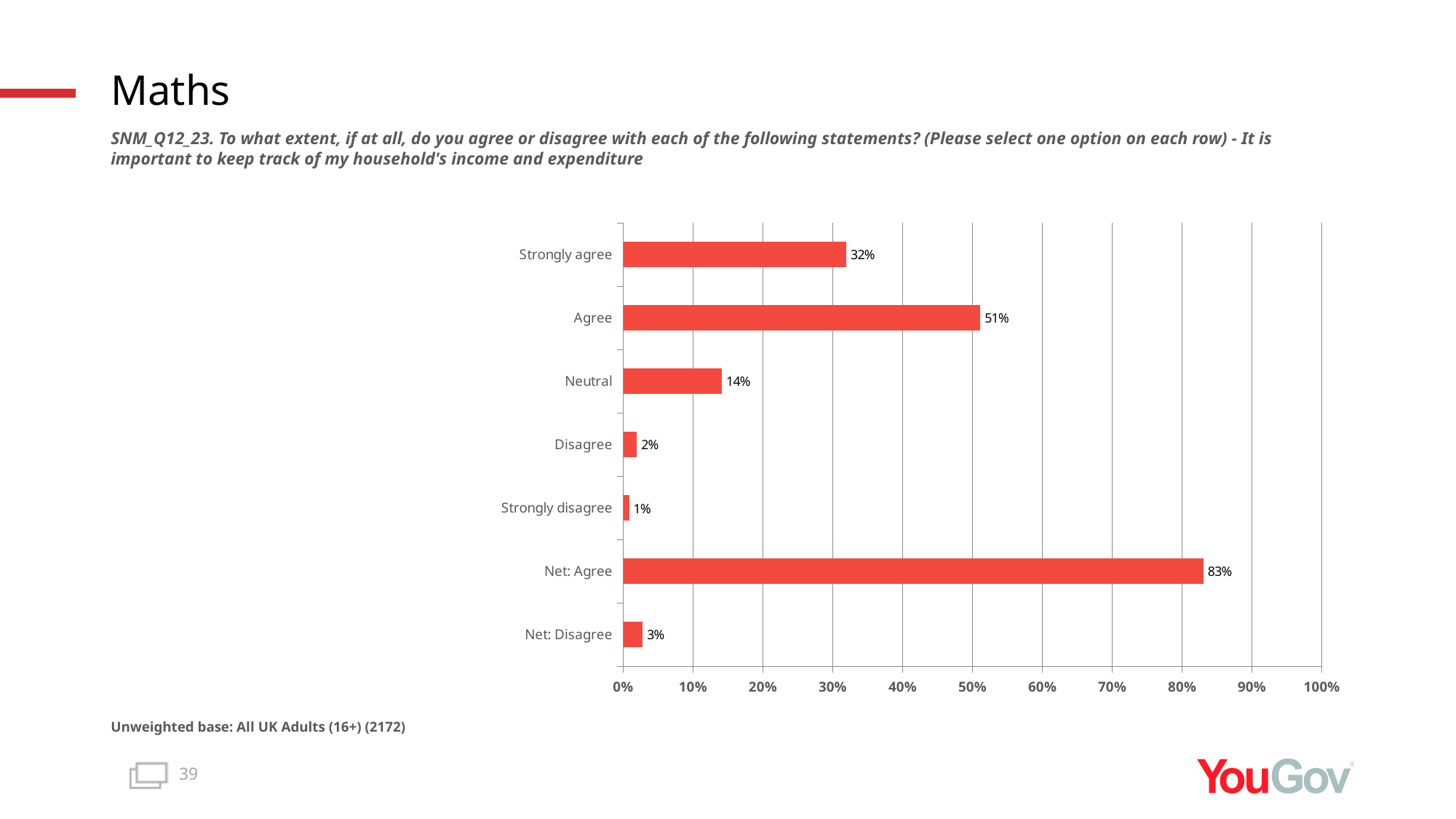
What percentage of respondents were 'Neutral'? 14% Is the value for 'Net: Agree' greater or less than 80%? greater How many categories are shown on the chart? 7 What is the value for 'Net: Disagree'? 3% What is the unweighted base stated below the chart? All UK Adults (16+) (2172) What percentage of respondents selected 'Strongly agree'? 32% What is the value shown for 'Agree'? 51% What is the difference between 'Agree' and 'Strongly agree'? 19% Which category has the lowest value? Strongly disagree Which is larger, 'Neutral' or 'Disagree'? Neutral What kind of chart is shown on the slide? Bar chart Which category has the highest value? Net: Agree